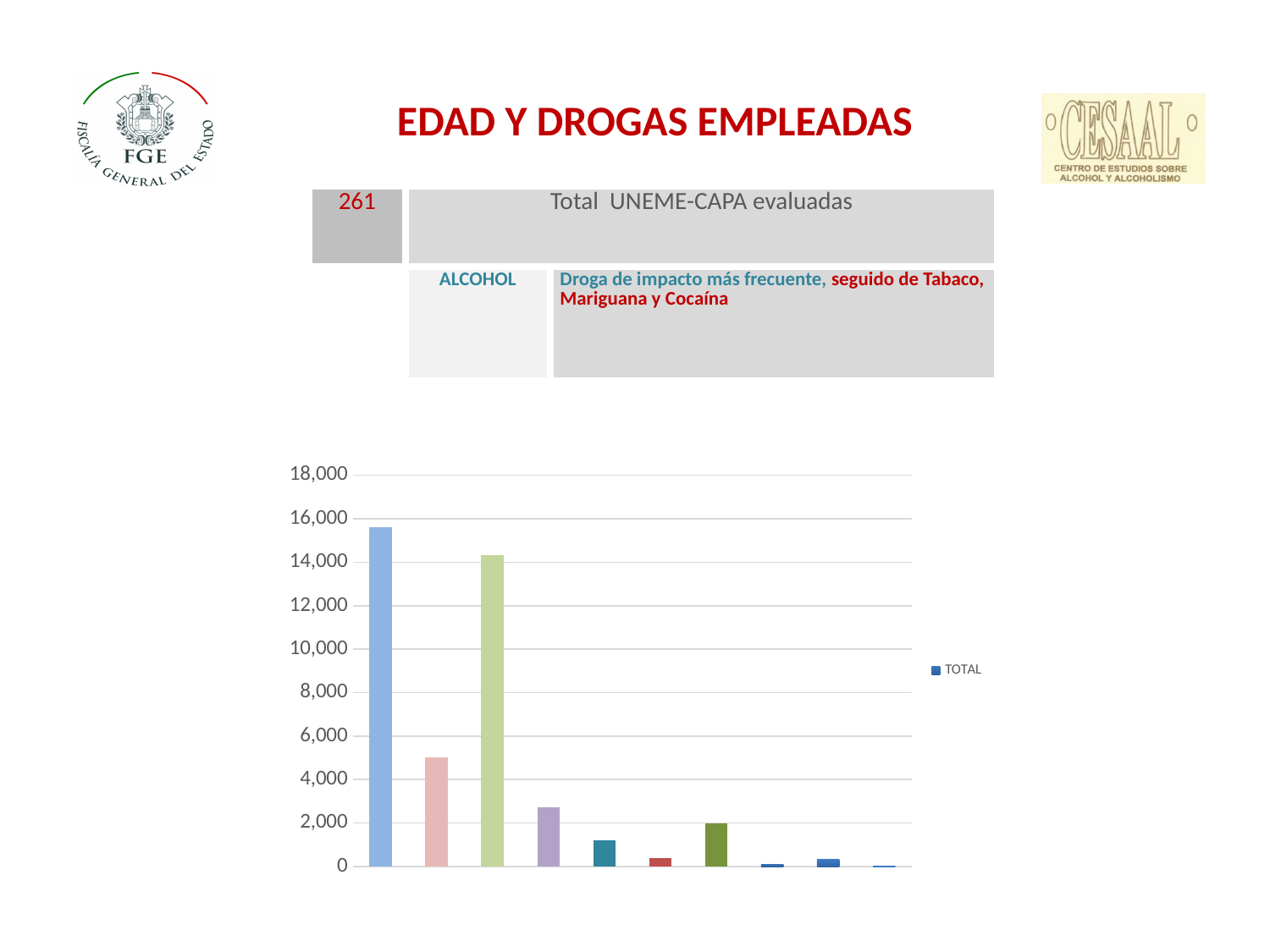
Which bar in the chart is the tallest, counting from the left? the first bar Is the value of the second bar from the left greater or less than 6,000? less Is the value of the fifth bar from the left greater or less than 2,000? less Is the value of the third bar from the left greater or less than 12,000? greater What is the name of the series shown in the chart legend? TOTAL What kind of chart is shown on the slide? bar chart How many bars are plotted in the chart? 10 What is the highest value shown on the vertical axis of the chart? 18,000 How many series does the chart legend list? 1 Which is larger, the first bar from the left or the third bar from the left? the first bar